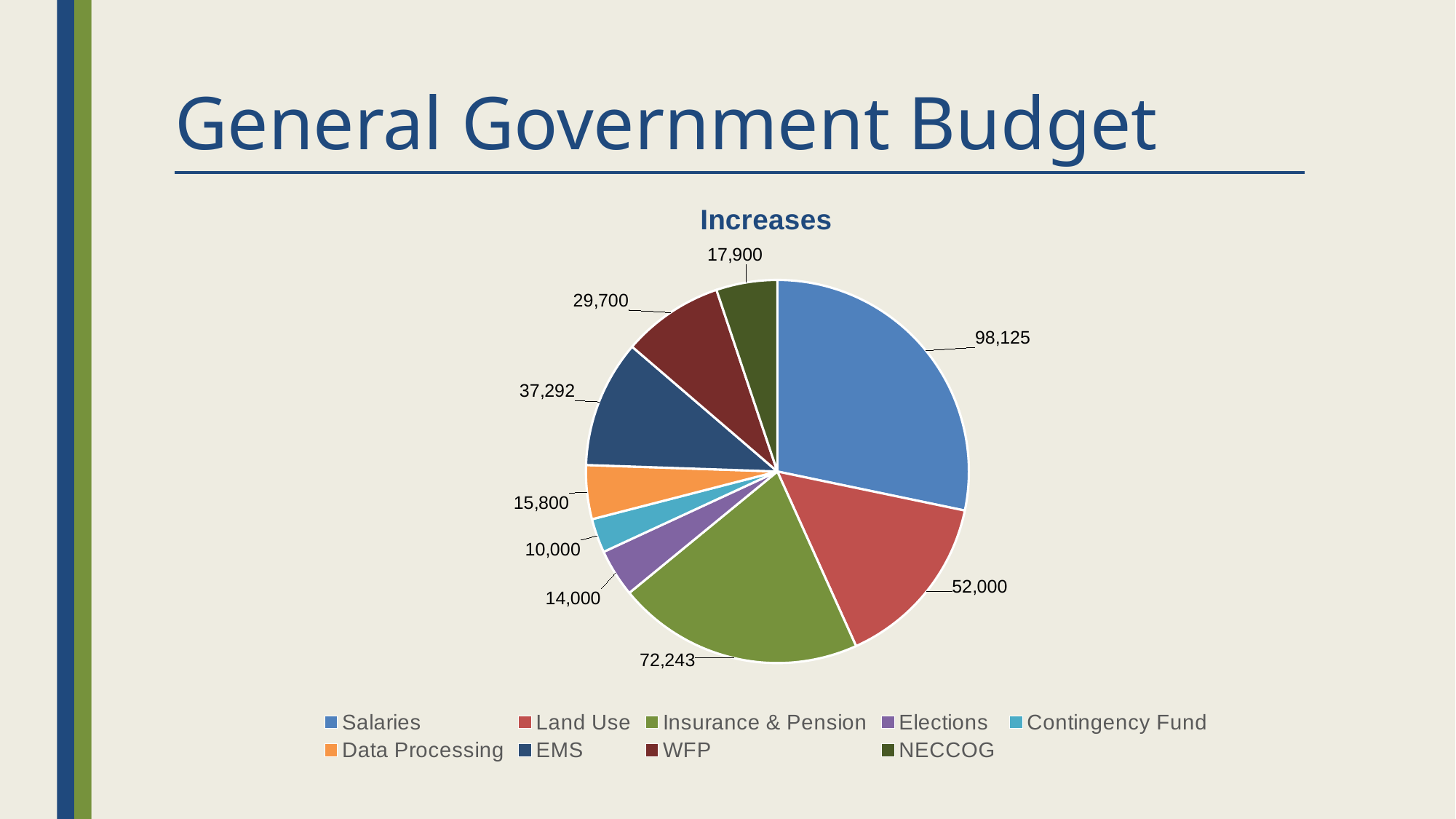
What is the difference between the values for Salaries and Land Use? 46,125 Which is larger, the value for WFP or the value for Elections? WFP What is the value for Insurance & Pension? 72,243 Which category has the largest slice? Salaries What type of chart is shown on the slide? Pie chart What is the difference between the values for Data Processing and Contingency Fund? 5,800 How many categories does the legend list? 9 Which category has the smallest slice? Contingency Fund What is the title of the chart? Increases What is the value for NECCOG? 17,900 What is the value for Salaries? 98,125 What is the value for EMS? 37,292